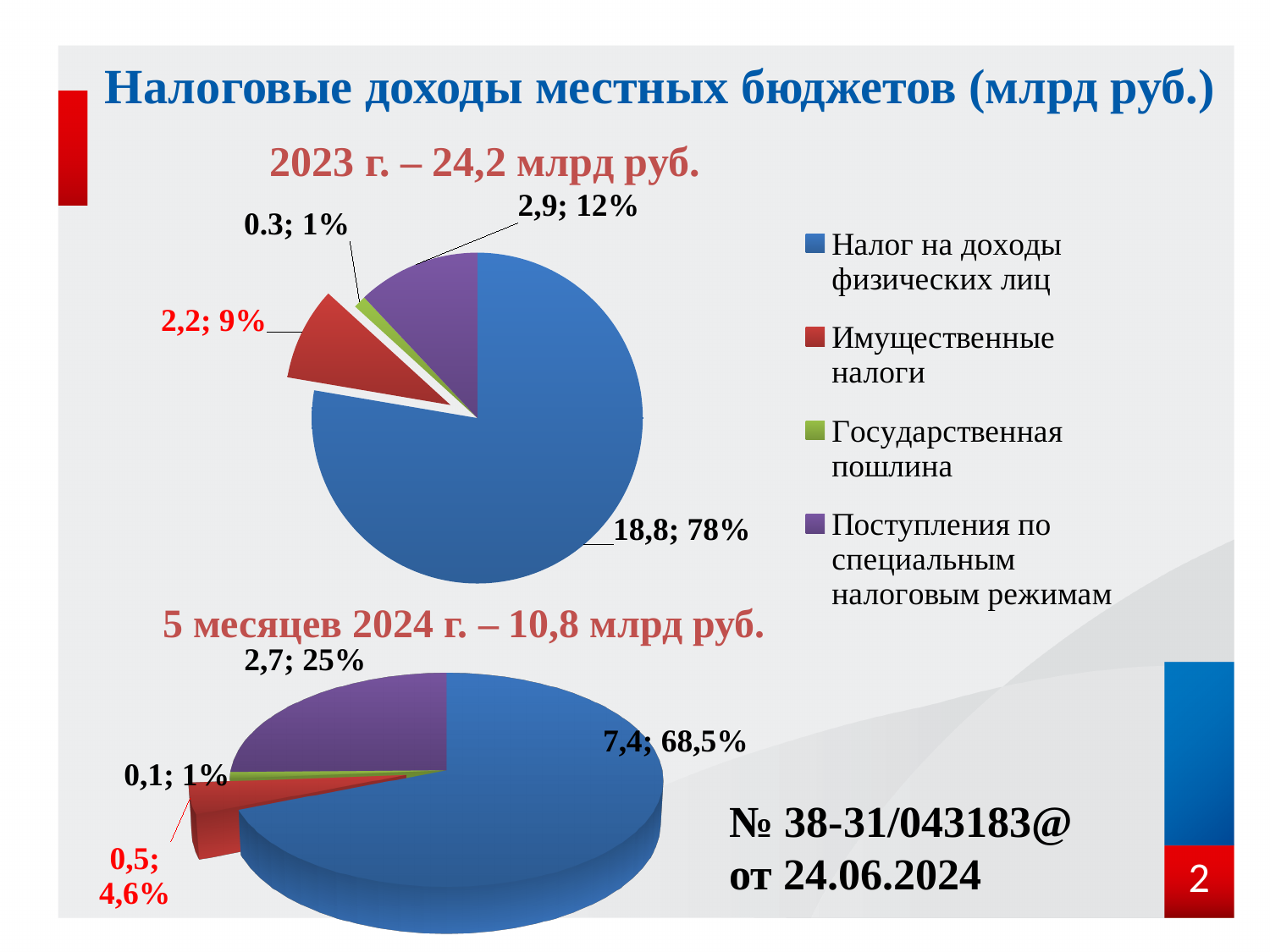
In the 5 месяцев 2024 г. chart, what is the value for Налог на доходы физических лиц? 7,4 In the 2023 chart, what is the difference between the values for Поступления по специальным налоговым режимам and Имущественные налоги? 0,7 In the 5 месяцев 2024 г. chart, what share of the pie is Имущественные налоги? 4,6% How many categories does the legend list? 4 In the 2023 chart, which category is the largest? Налог на доходы физических лиц In the 5 месяцев 2024 г. chart, what is the value for Поступления по специальным налоговым режимам? 2,7 In the 2023 chart, what share of the pie is Поступления по специальным налоговым режимам? 12% In the 2023 chart, what is the value for Налог на доходы физических лиц? 18,8 In the 2023 chart, which category is the smallest? Государственная пошлина What type of chart is the 2023 chart? Pie chart In the 2023 chart, what is the value for Имущественные налоги? 2,2 In the 5 месяцев 2024 г. chart, which is larger: Имущественные налоги or Поступления по специальным налоговым режимам? Поступления по специальным налоговым режимам